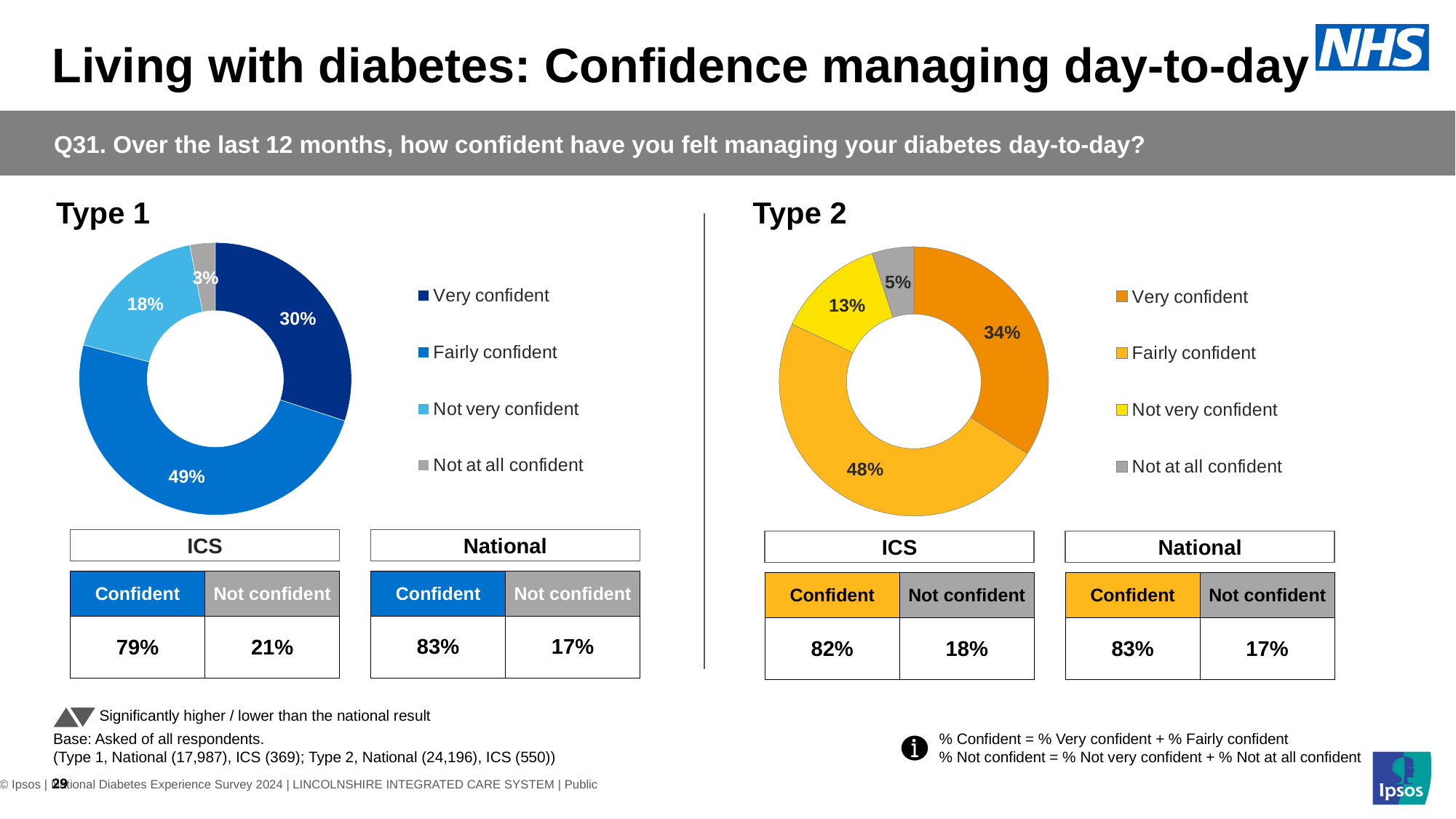
In the Type 2 chart, which is larger: Not very confident or Not at all confident? Not very confident In the Type 1 chart, what is the combined share of Very confident and Fairly confident? 79% In the Type 1 chart, which category has the largest share? Fairly confident How many categories does the Type 1 chart show? 4 What kind of chart is used for Type 2? Doughnut chart In the Type 1 chart, what percentage of respondents were Not very confident? 18% In the Type 2 chart, what colour represents Very confident? Orange In the Type 2 chart, what percentage of respondents were Fairly confident? 48% In the Type 1 chart, what percentage of respondents were Very confident? 30% In the Type 1 chart, what is the difference between the Fairly confident and Very confident shares? 19% In the Type 2 chart, which category has the smallest share? Not at all confident In the Type 2 chart, what is the combined share of Not very confident and Not at all confident? 18%